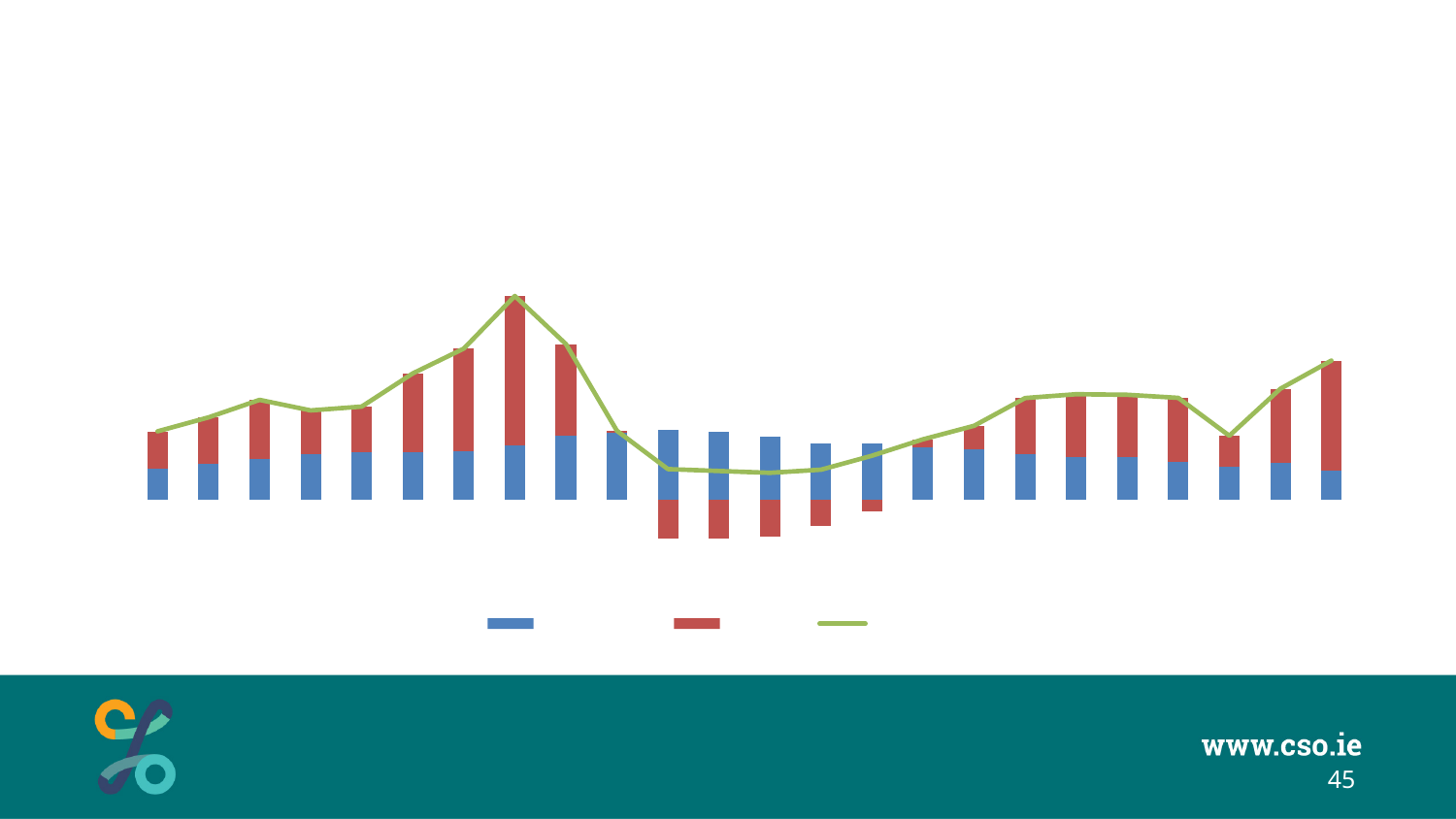
What kind of chart is shown on the slide? A stacked bar chart with a line What colour is the line series in the chart? Green Counting from the left, which bar is the tallest in the chart? The 8th bar What colours are used for the two bar series in the chart? Blue and red How many bars are plotted in the chart? 24 Does the green line rise or fall from the eighth bar to the eleventh bar? Fall How many bars have their red segment plotted below the zero line? 5 Does the green line rise or fall from the first bar to the eighth bar? Rise How many series does the legend list? 3 Is the green line at the 8th bar higher or lower than at the 24th bar? Higher